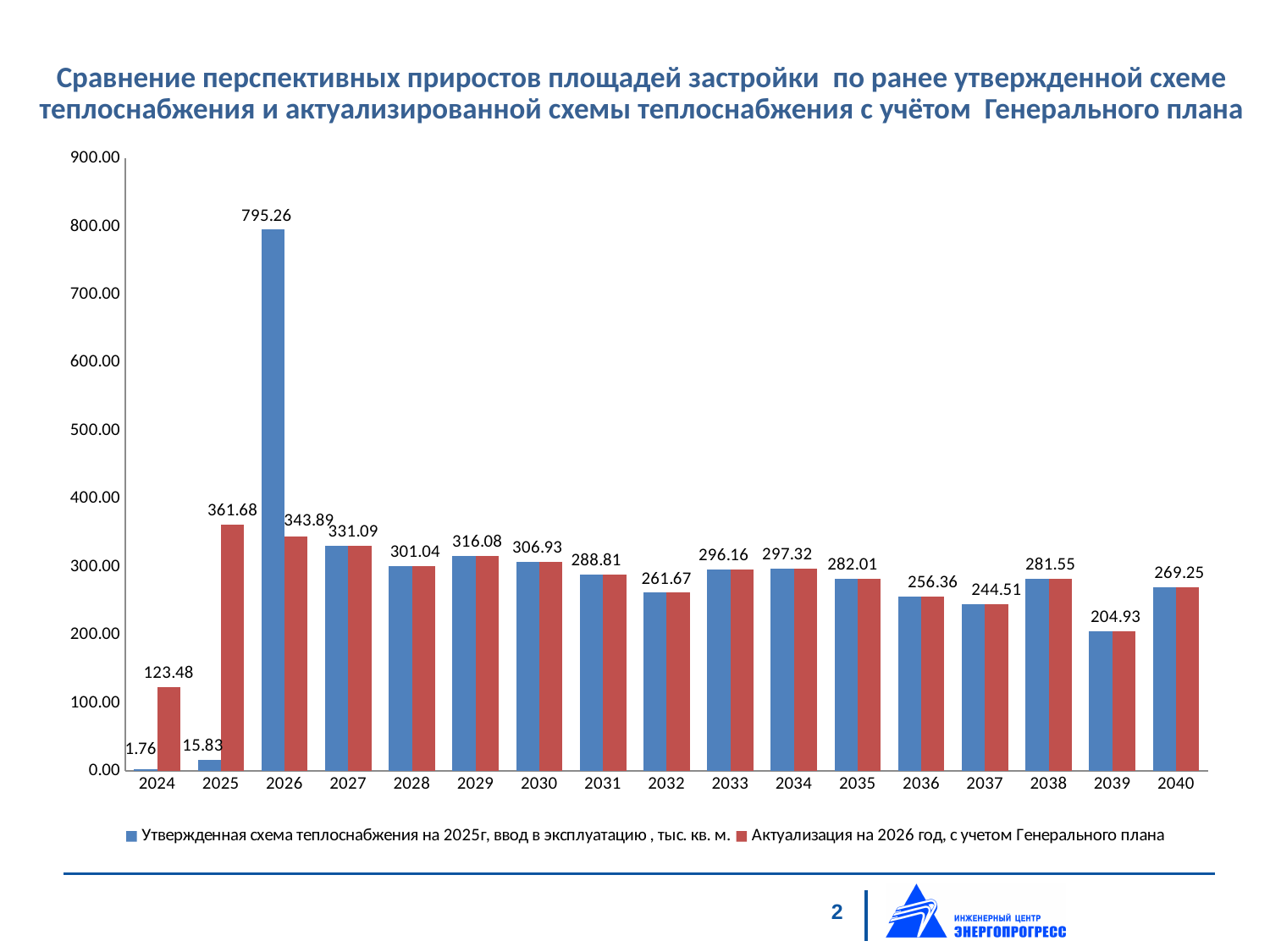
In which year is the 'Утвержденная схема теплоснабжения на 2025г' series lowest? 2024 What is the value of the 'Актуализация на 2026 год, с учетом Генерального плана' series for 2024? 123.48 What is the value of the 'Утвержденная схема теплоснабжения на 2025г' series for 2025? 15.83 How many series does the legend list? 2 In which year is the 'Утвержденная схема теплоснабжения на 2025г' series highest? 2026 For 2025, which series has the larger value? Актуализация на 2026 год, с учетом Генерального плана What is the value of the 'Утвержденная схема теплоснабжения на 2025г' series for 2026? 795.26 What value is labelled for 2039? 204.93 What kind of chart is shown on the slide? Bar chart What is the difference between the two series' values for 2026? 451.37 What is the value of the 'Актуализация на 2026 год' series for 2025? 361.68 How many years are shown on the x axis? 17